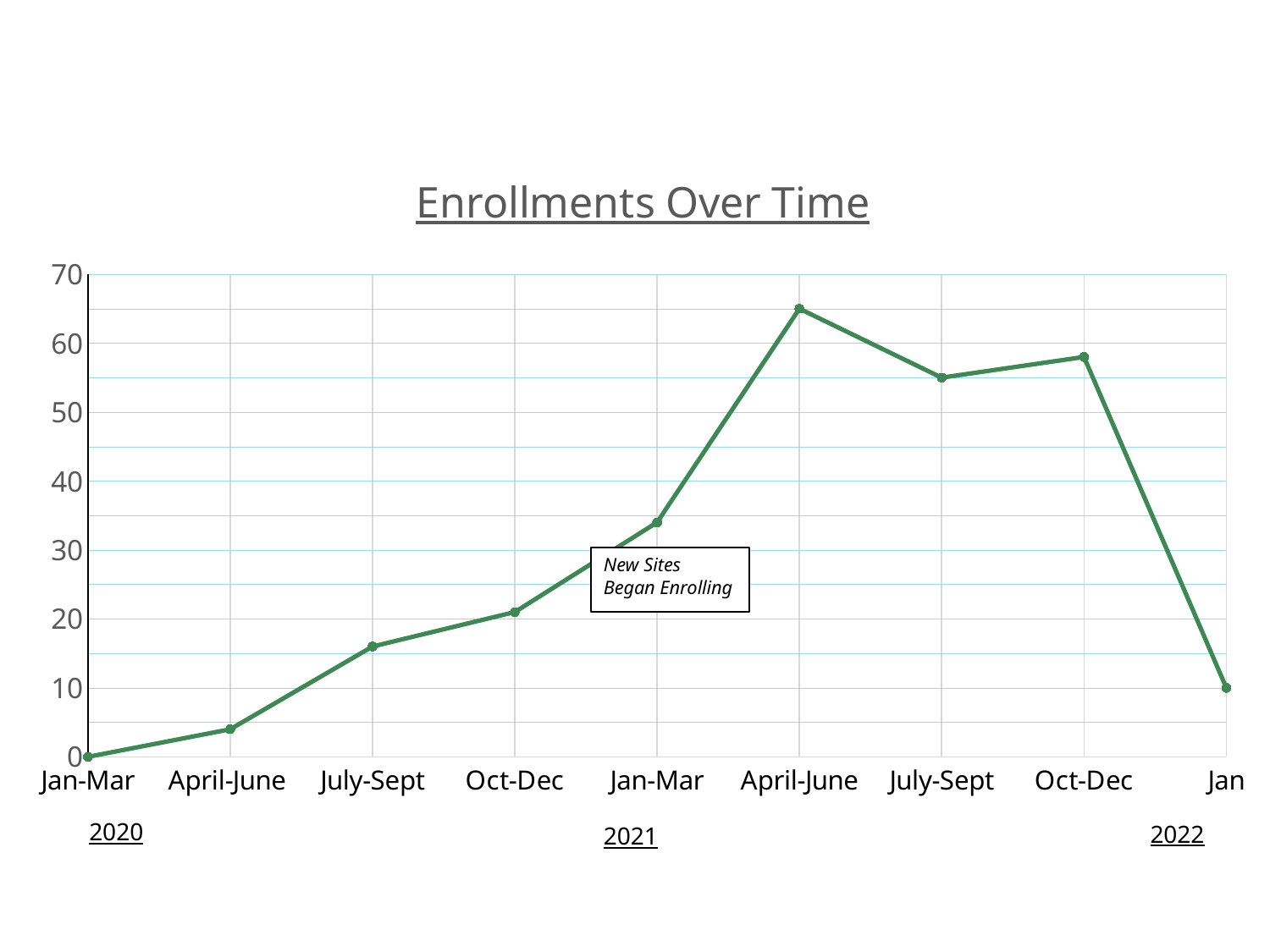
What is the enrollment value for Jan-Mar 2020? 0 What is the enrollment value for Jan 2022? 10 Which period has the highest enrollment value? April-June 2021 Which period has the lowest enrollment value? Jan-Mar 2020 What does the annotation box on the chart say? New Sites Began Enrolling How many data points are plotted on the line? 9 Is the value for Oct-Dec 2021 greater or less than 60? less Is the value for April-June 2021 greater or less than 60? greater What type of chart is shown on the slide? Line chart Do enrollments rise or fall from Jan-Mar 2020 to April-June 2021? rise Is the value for Jan-Mar 2021 greater or less than 30? greater What is the title of the chart? Enrollments Over Time